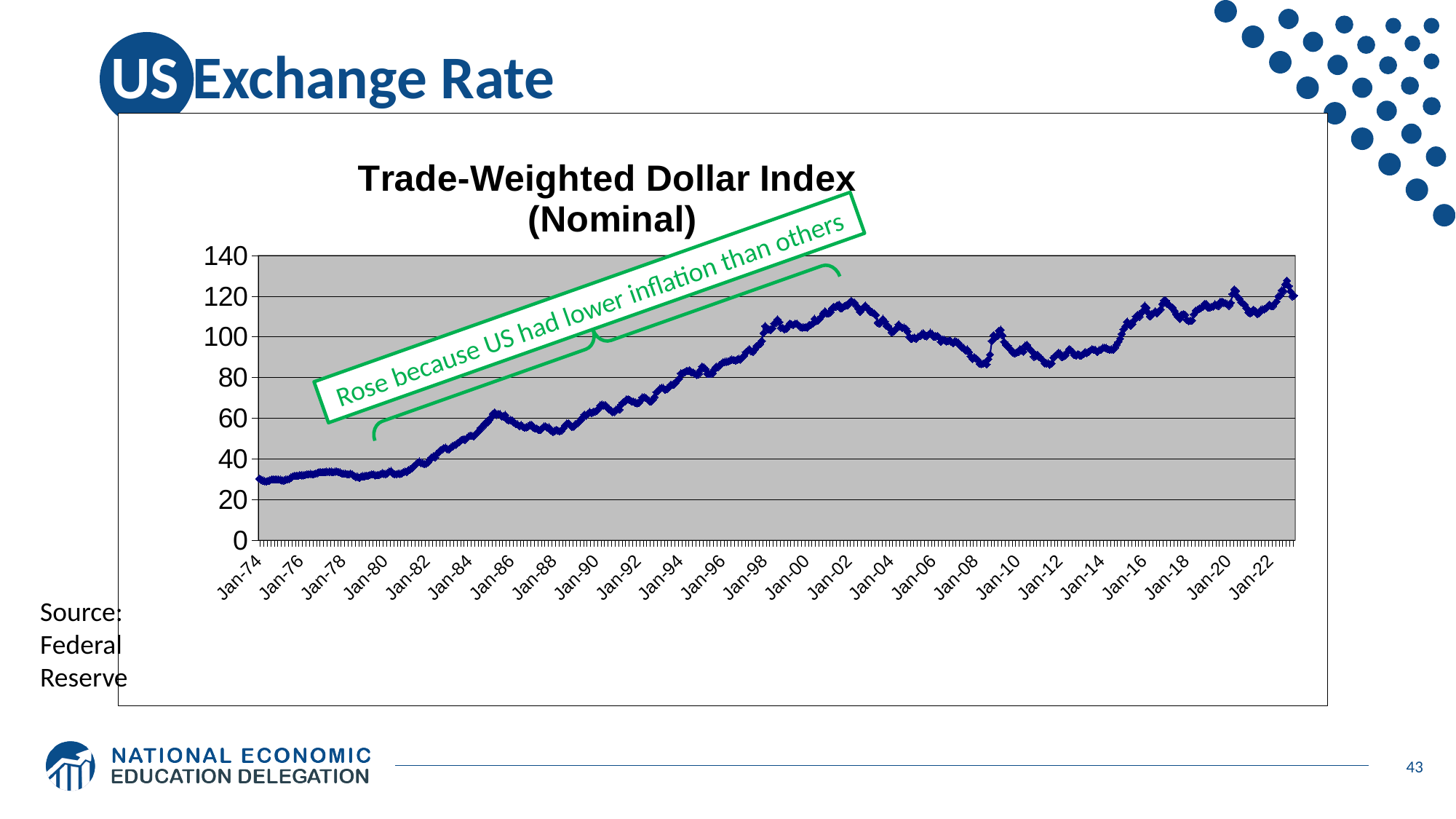
Is the value of the index at Jan-74 greater or less than 40? less Is the value of the index at Jan-22 greater or less than 100? greater Is the value of the index at Jan-80 greater or less than 60? less How many date labels are shown on the x axis? 25 What is the title of the chart? Trade-Weighted Dollar Index (Nominal) Which is larger, the index value at Jan-02 or at Jan-74? Jan-02 Which is larger, the index value at Jan-86 or at Jan-96? Jan-96 What kind of chart is shown on the slide? line chart Overall, does the Trade-Weighted Dollar Index rise or fall from Jan-74 to the end of the series? rise What is the highest value shown on the y axis? 140